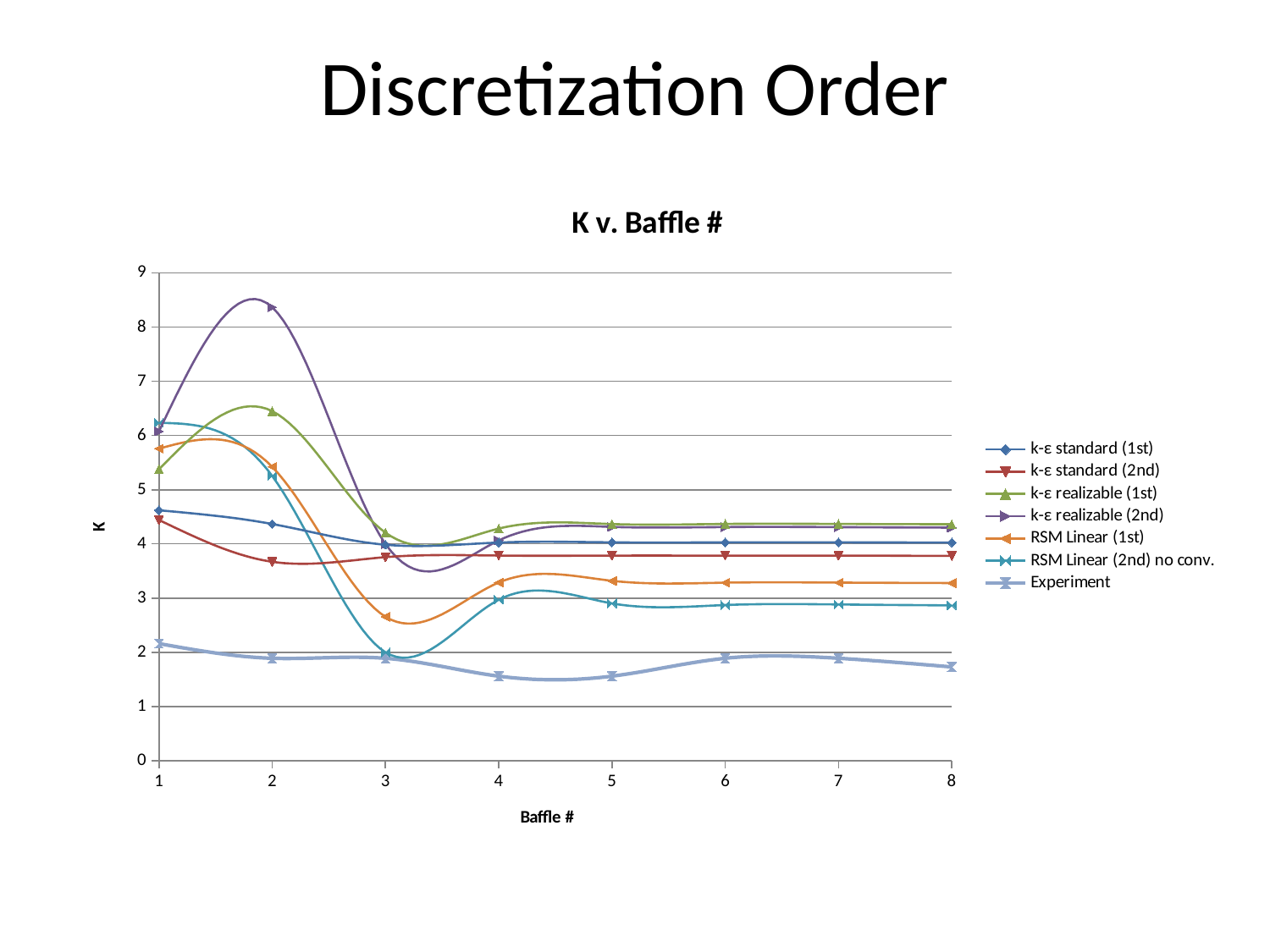
How many baffle numbers are plotted along the x axis of the chart? 8 What is the label on the x axis of the chart? Baffle # How many series does the legend of the K v. Baffle # chart list? 7 At baffle 1, which is larger: k-ε realizable (1st) or k-ε standard (1st)? k-ε realizable (1st) Is the value for RSM Linear (2nd) no conv. at baffle 3 greater or less than 3? less Is the value for k-ε realizable (2nd) at baffle 2 greater or less than 8? greater Which series has the lowest value at baffle 1? Experiment Does the Experiment series rise or fall from baffle 1 to baffle 2? fall What kind of chart is shown on the slide? line chart Is the value for Experiment at baffle 4 greater or less than 2? less Which series has the highest value at baffle 2? k-ε realizable (2nd) What is the title of the chart? K v. Baffle #